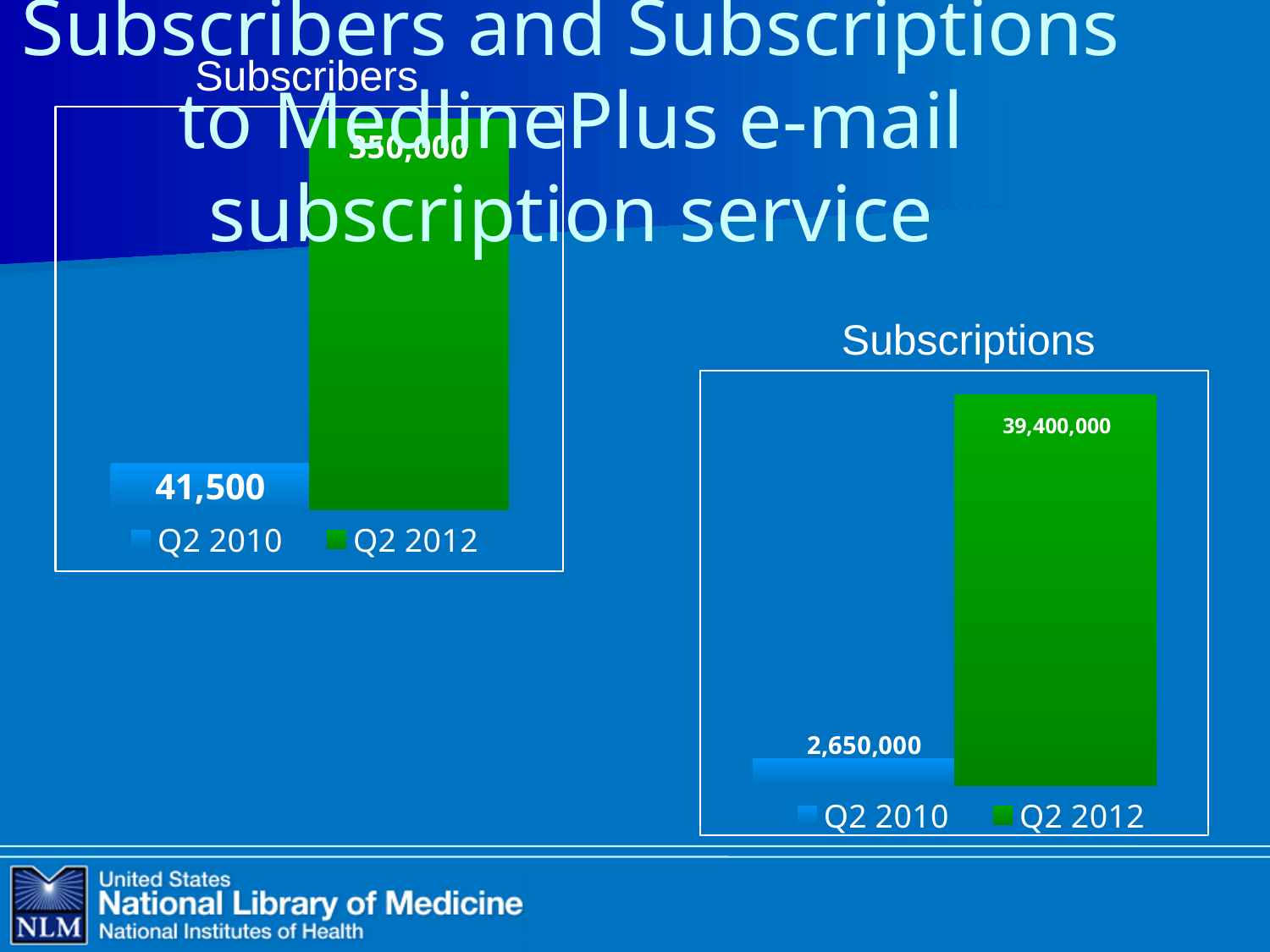
In the Subscriptions chart, what colour is the Q2 2012 bar? green What kind of chart is the Subscribers chart? bar chart In the Subscribers chart, which period has the lower value? Q2 2010 In the Subscriptions chart, which period has the higher value? Q2 2012 In the Subscribers chart, is the value for Q2 2012 larger or smaller than the value for Q2 2010? larger How many series does the legend of the Subscriptions chart list? 2 In the Subscriptions chart, what is the value for Q2 2010? 2,650,000 How many charts are shown on the slide? 2 In the Subscribers chart, what is the value for Q2 2010? 41,500 In the Subscriptions chart, do the values rise or fall from Q2 2010 to Q2 2012? rise In the Subscriptions chart, what is the value for Q2 2012? 39,400,000 In the Subscriptions chart, what is the difference between the Q2 2012 and Q2 2010 values? 36,750,000